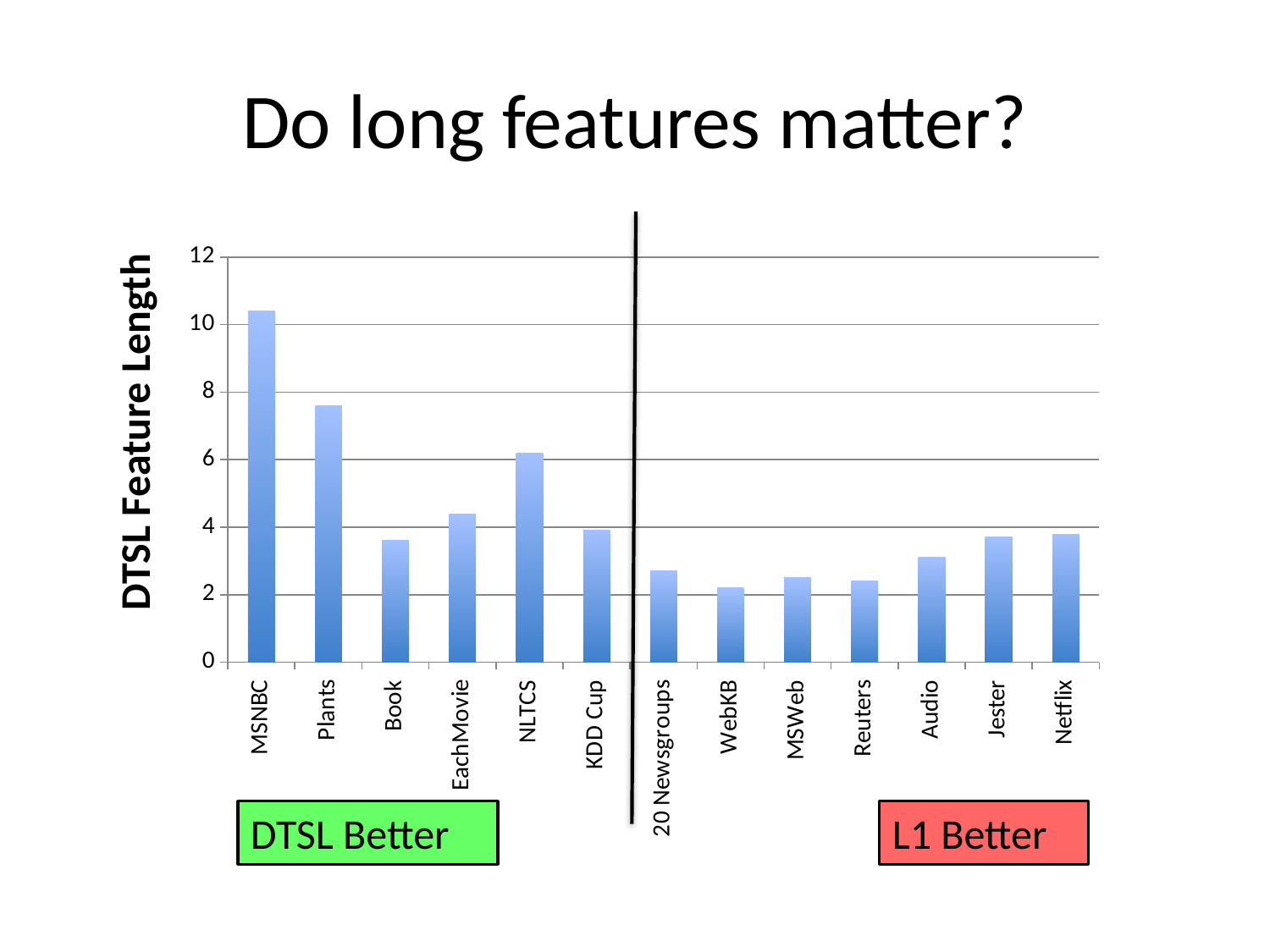
Is the value for Book greater or less than 4? less Is the value for NLTCS greater or less than 6? greater How many datasets (categories) are plotted on the x axis? 13 Which dataset has the highest DTSL feature length? MSNBC What is the label on the vertical axis? DTSL Feature Length What kind of chart is shown on the slide? bar chart What does the green box below the left group of bars say? DTSL Better Which has a larger DTSL feature length, NLTCS or EachMovie? NLTCS Is the value for Audio greater or less than 2? greater Which has a larger DTSL feature length, MSNBC or Plants? MSNBC